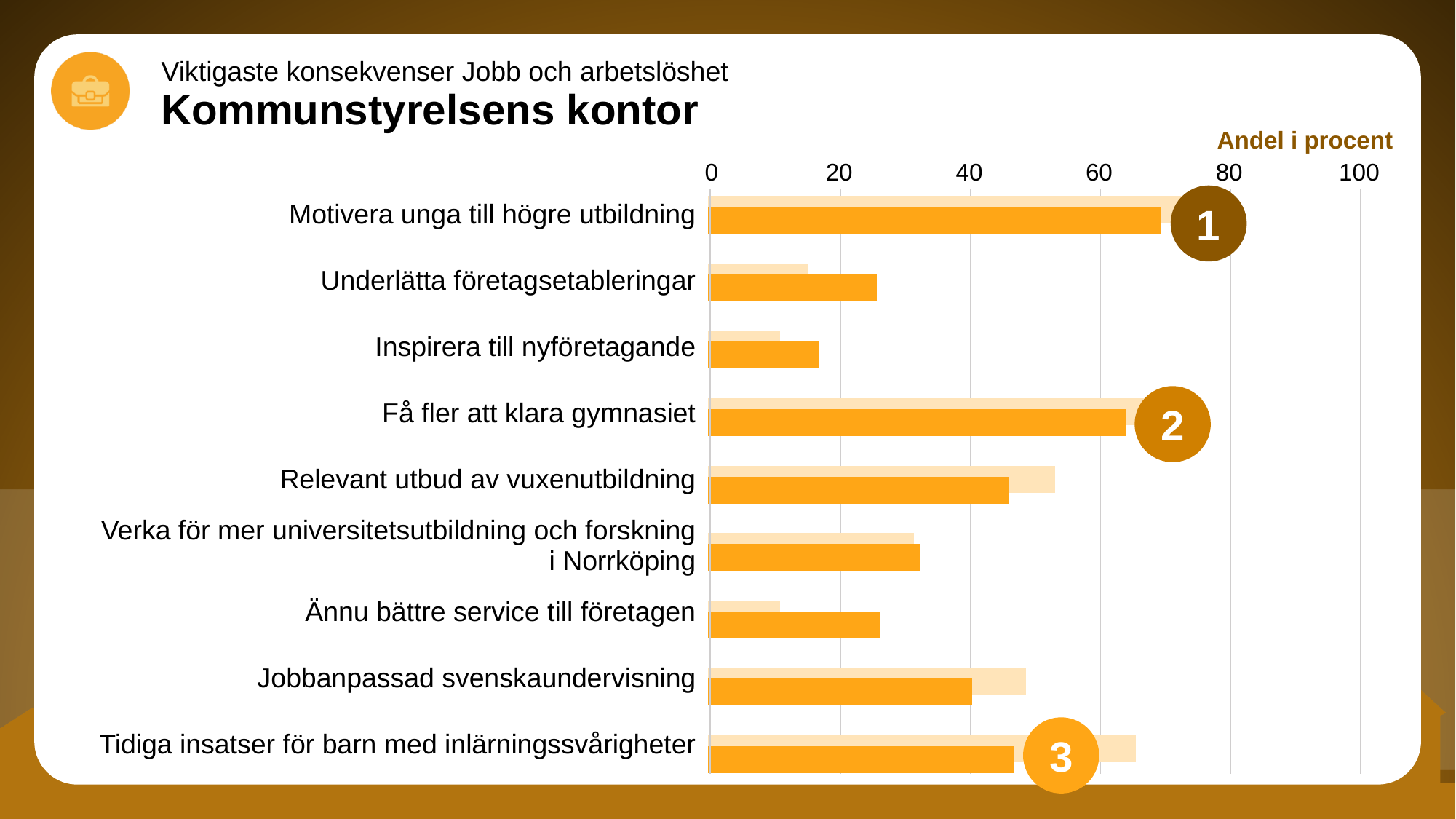
Is the dark orange bar for Inspirera till nyföretagande greater or less than 20? less What label is shown above the horizontal axis of the chart? Andel i procent Is the dark orange bar for Jobbanpassad svenskaundervisning greater or less than 60? less Which category has the shortest dark orange bar? Inspirera till nyföretagande What kind of chart is shown on the slide? bar chart Which has the longer dark orange bar: Relevant utbud av vuxenutbildning or Verka för mer universitetsutbildning och forskning i Norrköping? Relevant utbud av vuxenutbildning What is the main title of the chart slide? Kommunstyrelsens kontor Which has the longer dark orange bar: Få fler att klara gymnasiet or Tidiga insatser för barn med inlärningssvårigheter? Få fler att klara gymnasiet Which category has the longest dark orange bar? Motivera unga till högre utbildning Is the dark orange bar for Motivera unga till högre utbildning greater or less than 60? greater How many categories are plotted on the chart? 9